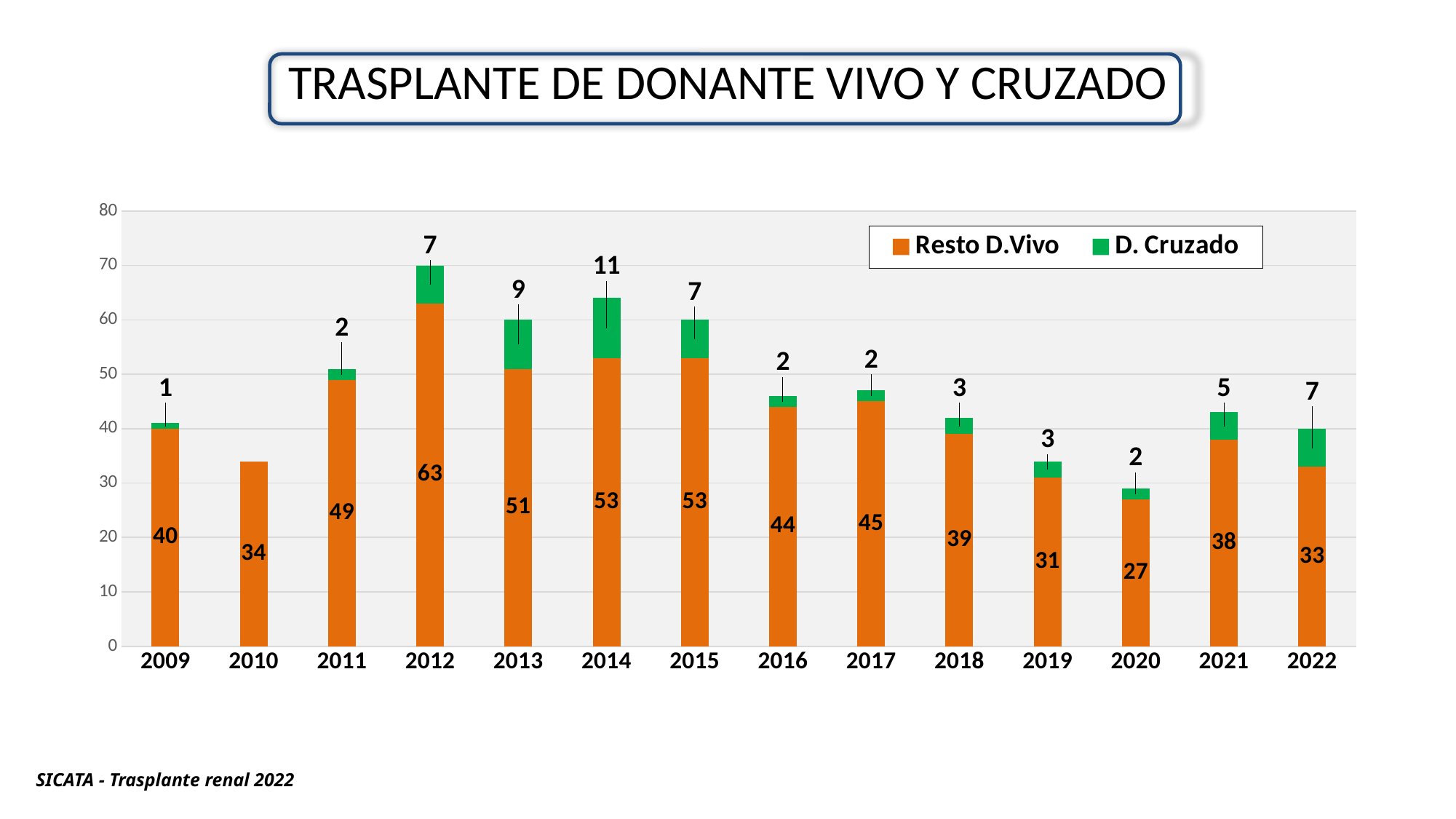
What type of chart is shown on the slide? Stacked bar chart What is the value of D. Cruzado for 2014? 11 What is the total of the stacked bar for 2013? 60 Which is larger, the Resto D.Vivo value for 2016 or for 2017? 2017 How many series does the legend list? 2 What is the value of Resto D.Vivo for 2012? 63 What is the value of Resto D.Vivo for 2020? 27 What is the difference between the Resto D.Vivo values for 2012 and 2022? 30 Which year has the lowest Resto D.Vivo value? 2020 Which year has the highest Resto D.Vivo value? 2012 Which year has the highest D. Cruzado value? 2014 How many years are shown on the x axis? 14